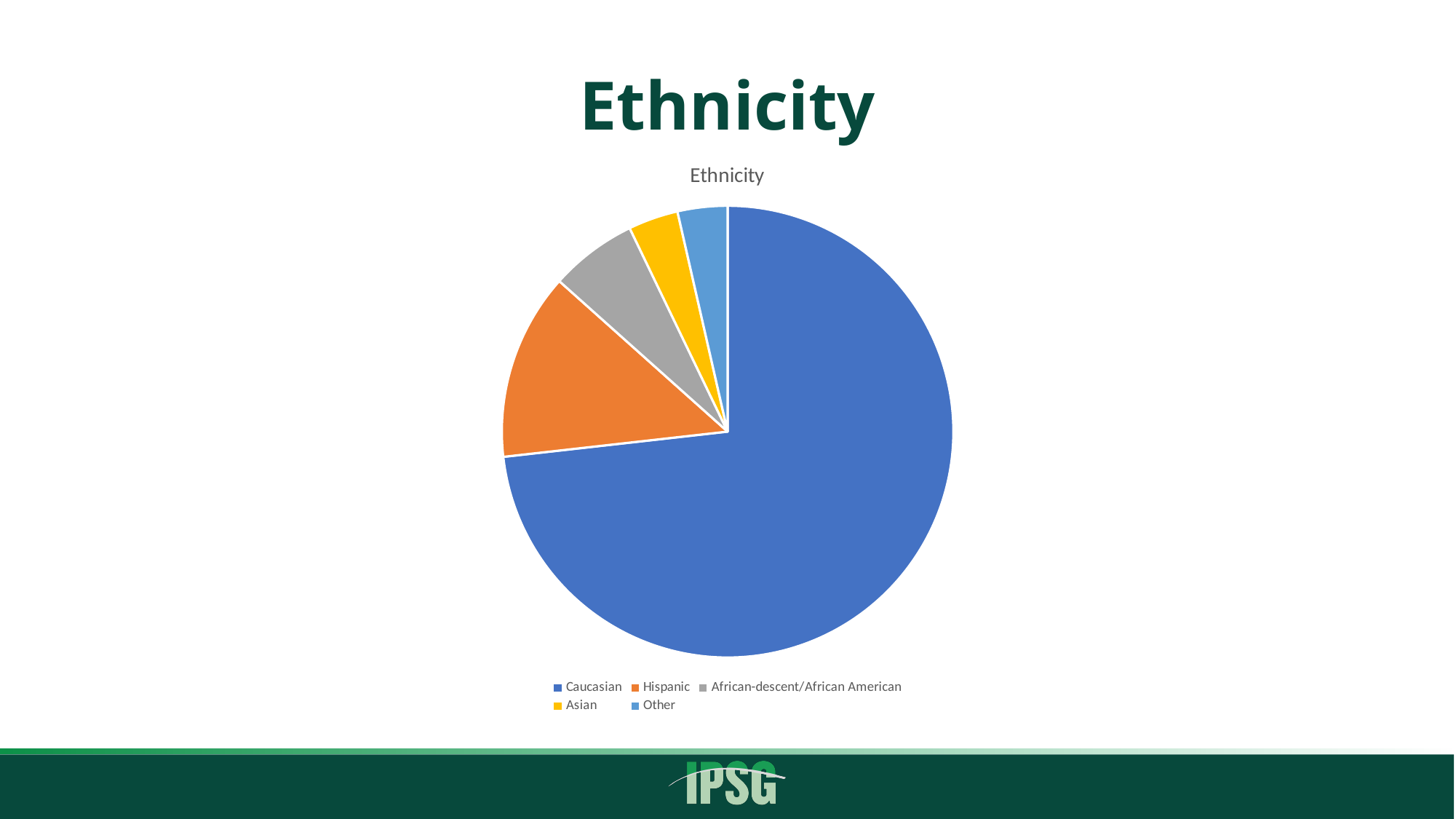
Which is larger, the Hispanic slice or the African-descent/African American slice? Hispanic How many categories (slices) does the pie chart have? 5 How many entries does the legend list? 5 Which is larger, the Caucasian slice or the Hispanic slice? Caucasian Which is larger, the African-descent/African American slice or the Other slice? African-descent/African American What is the title of the chart? Ethnicity What kind of chart is shown on the slide? Pie chart Which category has the largest slice of the pie? Caucasian Which category is shown in orange? Hispanic